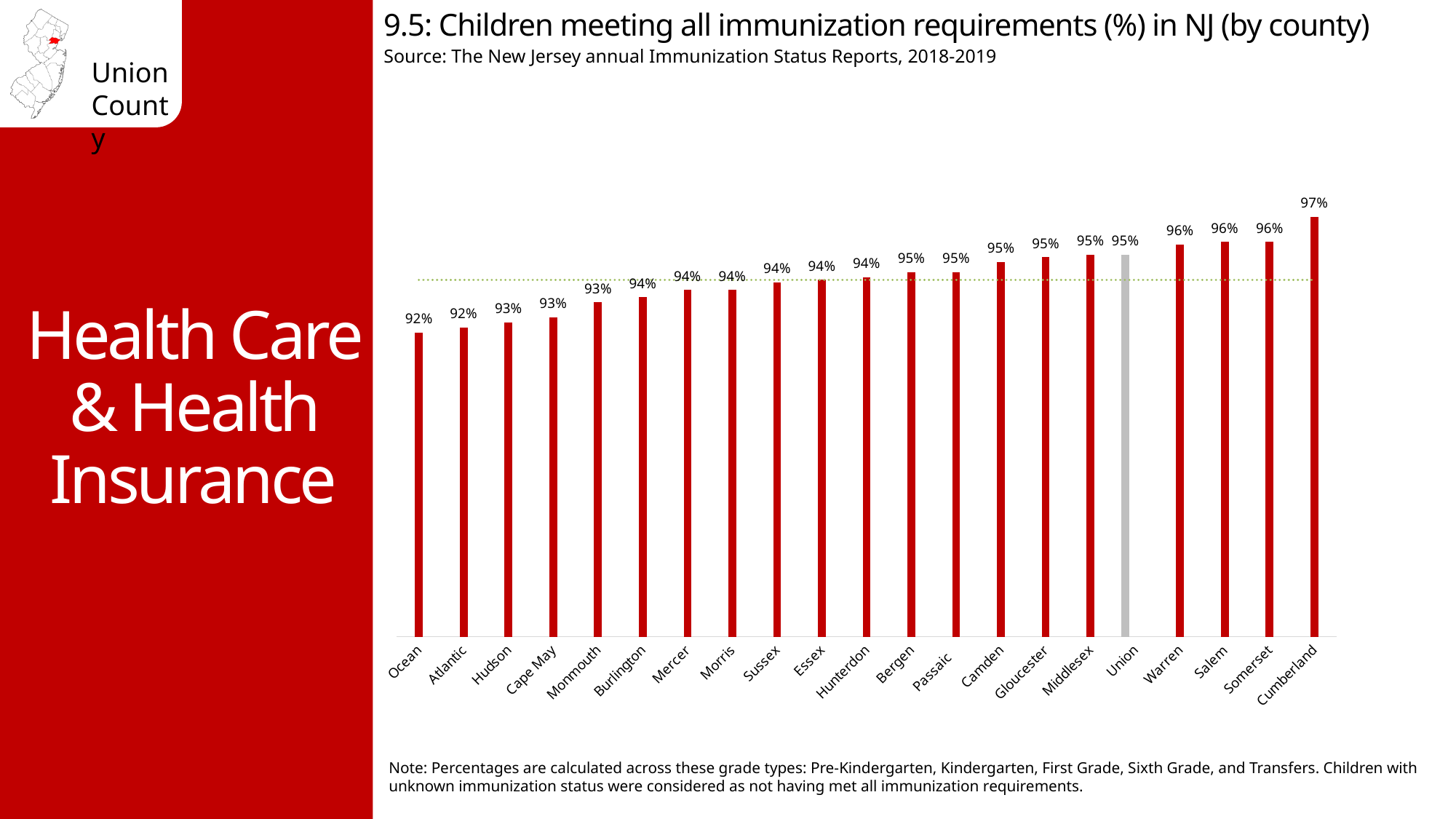
Which county's bar is coloured grey instead of red? Union What is the value shown for Monmouth County? 93% Do the values rise or fall moving from left to right along the x axis? Rise Which county has a higher value, Hudson or Somerset? Somerset What is the difference in percentage points between Cumberland and Ocean counties? 5 percentage points What kind of chart is shown on the slide? Bar chart What is the value shown for Ocean County? 92% What percentage of children in Union County met all immunization requirements? 95% Which county has the highest percentage of children meeting all immunization requirements? Cumberland How many counties are shown on the chart? 21 What is the value shown for Warren County? 96% What is the value shown for Cumberland County? 97%